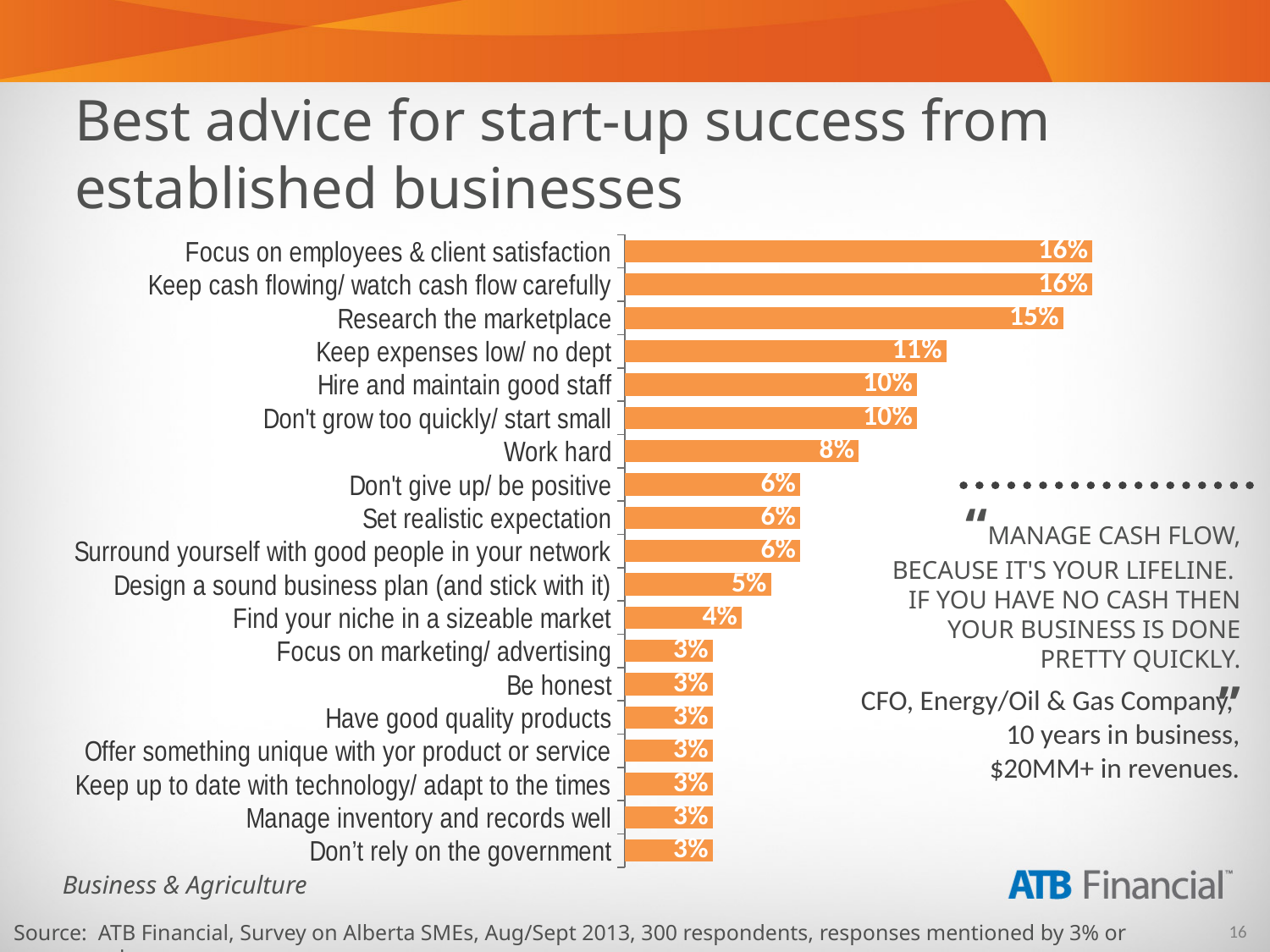
What is the value for "Find your niche in a sizeable market"? 4% What is the difference between the value for "Research the marketplace" and the value for "Work hard"? 7% What is the highest percentage shown on the chart? 16% What type of chart is shown on the slide? Bar chart What is the value for "Work hard"? 8% Which has a larger value: "Hire and maintain good staff" or "Design a sound business plan (and stick with it)"? Hire and maintain good staff What percentage of established businesses advised to research the marketplace? 15% What is the value for "Keep expenses low/ no dept"? 11% What colour are the bars in the chart? Orange What is the lowest percentage shown on the chart? 3% How many pieces of advice (categories) are shown on the chart? 19 Do the values increase or decrease going from the top category to the bottom category? Decrease